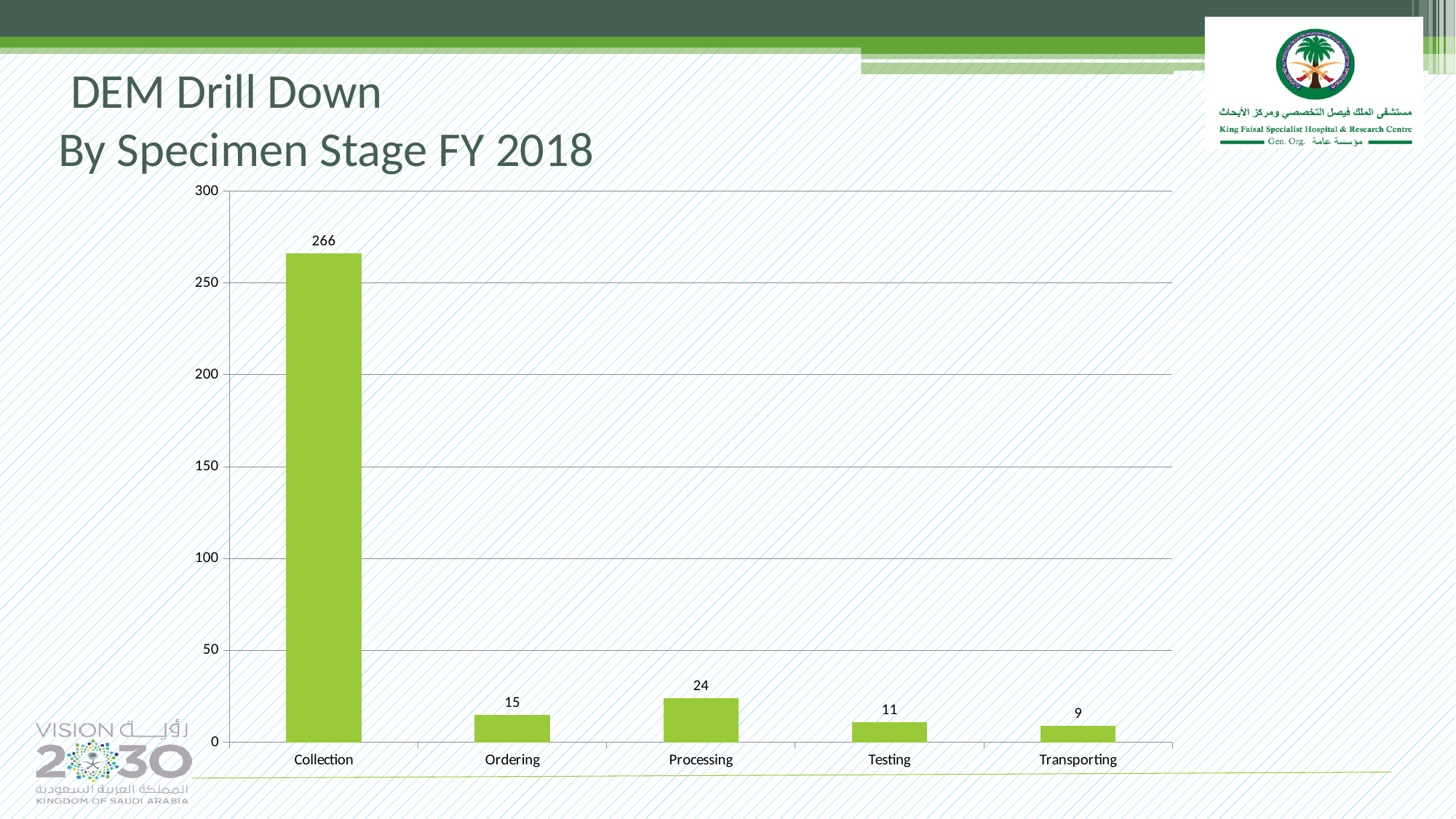
Which specimen stage has the lowest value? Transporting Is the value for Collection greater or less than 250? greater What kind of chart is shown on the slide? Bar chart Which specimen stage has the highest value? Collection What is the value for Processing? 24 What is the difference between the values for Collection and Processing? 242 What is the value for Transporting? 9 Which is larger, the value for Ordering or the value for Processing? Processing What is the difference between the values for Ordering and Testing? 4 What is the value for Collection? 266 What is the title of the slide containing the chart? DEM Drill Down By Specimen Stage FY 2018 How many specimen stages are shown on the x axis? 5